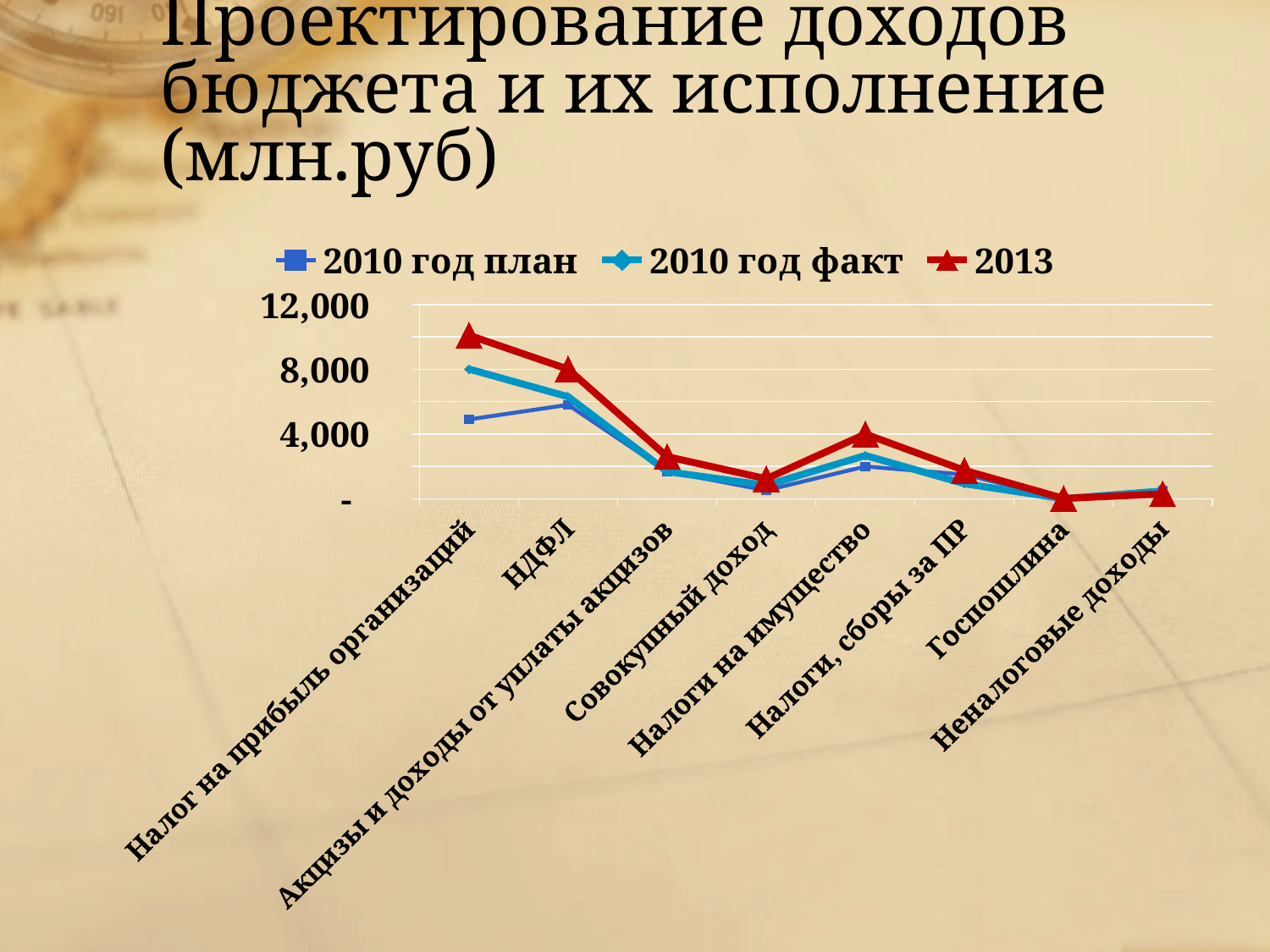
Is the 2013 value for Акцизы и доходы от уплаты акцизов greater or less than 4,000? less What kind of chart is shown on the slide? line chart Is the 2010 год факт value for НДФЛ greater or less than 8,000? less How many series does the legend list? 3 Do the values of the 2013 series generally rise or fall from left to right along the x axis? fall Which series is drawn in red with triangle markers? 2013 Which category has the highest value for the 2013 series? Налог на прибыль организаций Is the 2010 год план value for Налог на прибыль организаций greater or less than 4,000? greater Which category has the lowest value for the 2013 series? Госпошлина For Налог на прибыль организаций, which is larger: the 2013 value or the 2010 год план value? 2013 How many categories are plotted along the x axis? 8